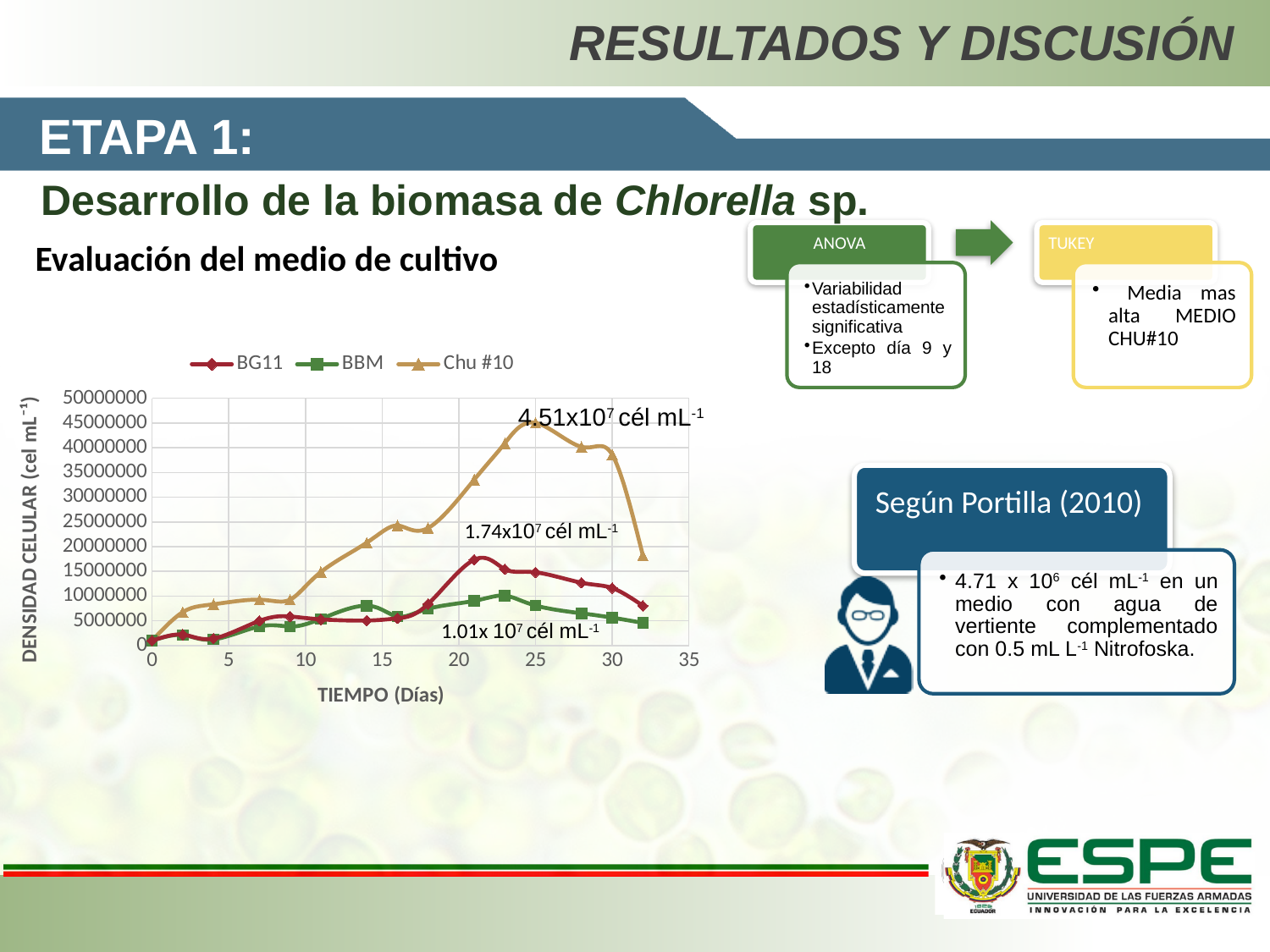
How many series does the chart legend list? 3 What peak value is annotated for the Chu #10 series? 4.51x10⁷ cél mL⁻¹ What are the three series named in the chart legend? BG11, BBM, Chu #10 What peak value is annotated for the BBM series? 1.01x10⁷ cél mL⁻¹ Which series reaches the highest cell density in the chart? Chu #10 Is the value for Chu #10 at day 25 greater or less than 40000000? greater What kind of chart is shown on the slide? line chart At day 25, which series has the higher cell density, Chu #10 or BG11? Chu #10 What is the title of the x axis of the chart? TIEMPO (Días) Does the Chu #10 series rise or fall between day 25 and day 32? fall What peak value is annotated for the BG11 series? 1.74x10⁷ cél mL⁻¹ Which series has the lowest peak cell density in the chart? BBM